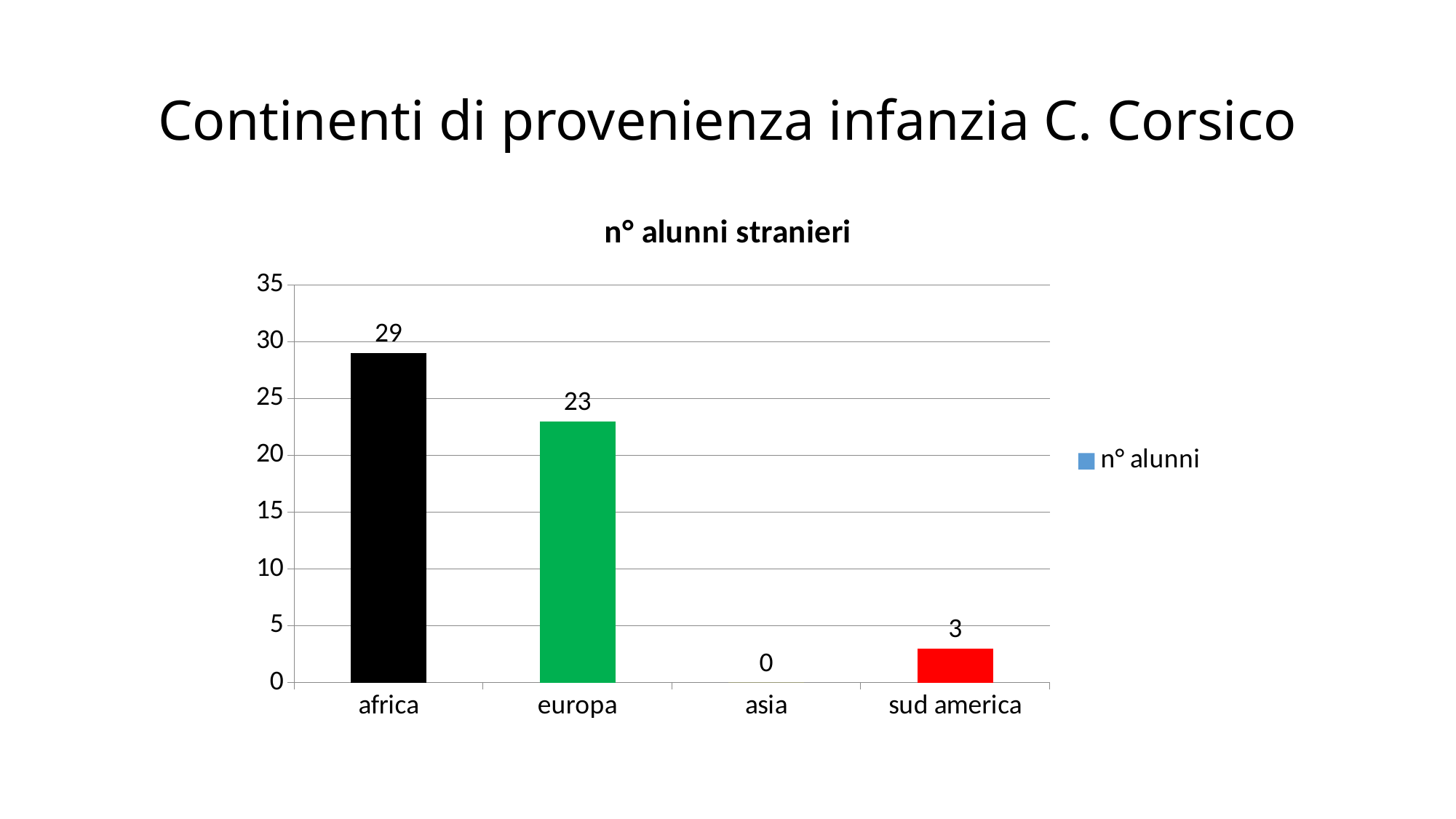
What is the title of the chart? n° alunni stranieri How many categories are shown on the x axis? 4 What is the difference between the values for africa and europa? 6 Is the value for africa greater or less than 25? greater What is the value for sud america? 3 What is the value for africa? 29 Which category has the highest value? africa What kind of chart is shown? bar chart What is the value for europa? 23 Which category has the lowest value? asia What is the value for asia? 0 Which is larger, the value for europa or the value for sud america? europa